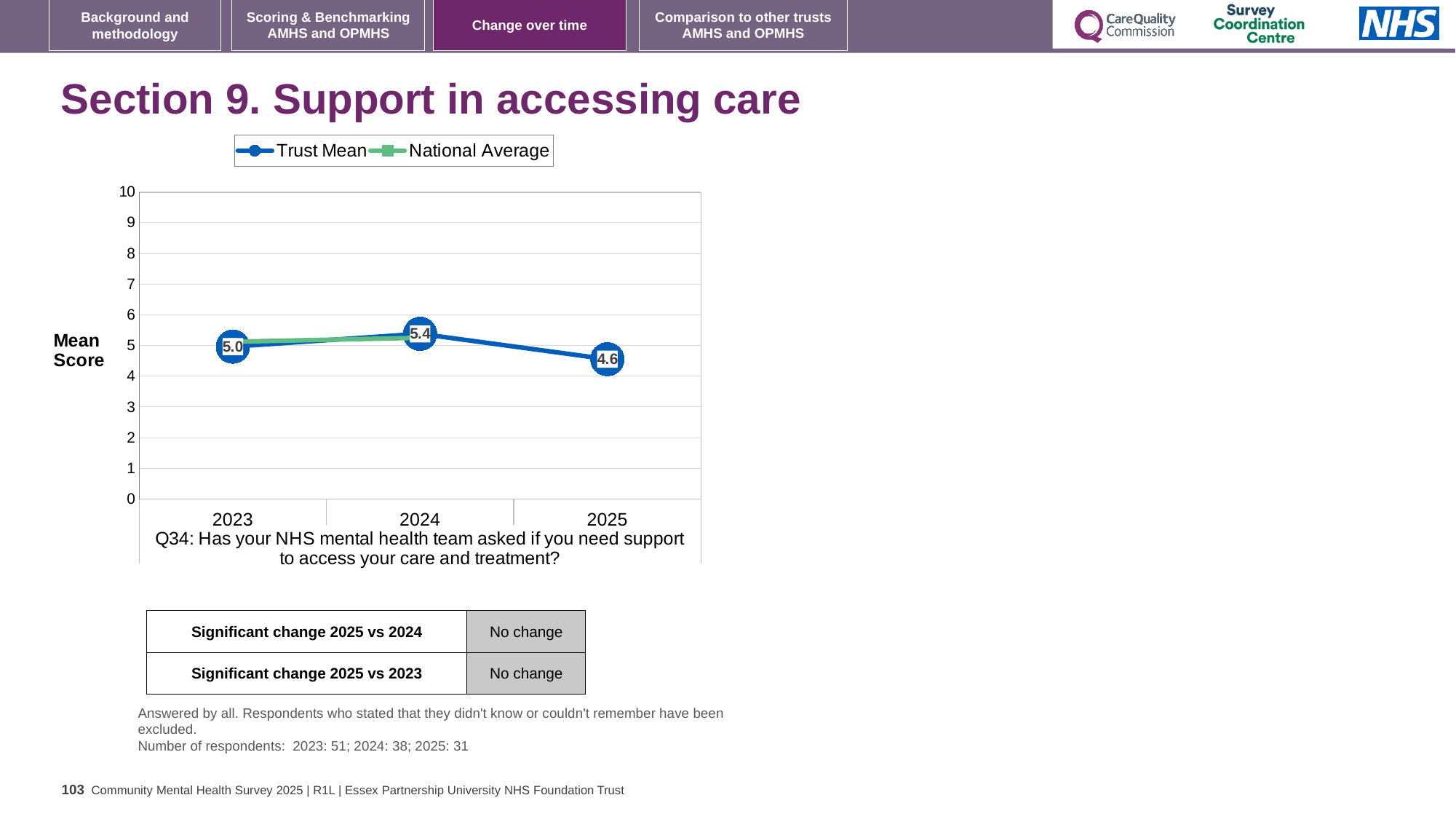
What is the Trust Mean score for 2023? 5.0 What is the Trust Mean score for 2024? 5.4 What kind of chart is shown on the slide? Line chart In which year is the Trust Mean score lowest? 2025 Does the Trust Mean score rise or fall from 2024 to 2025? Fall What is the difference between the Trust Mean scores for 2024 and 2025? 0.8 How many series does the chart legend list? 2 How many years are shown on the x axis of the chart? 3 What is the Trust Mean score for 2025? 4.6 In which year is the Trust Mean score highest? 2024 Is the National Average value for 2024 greater or less than 6? less Which year has the larger Trust Mean score, 2023 or 2025? 2023